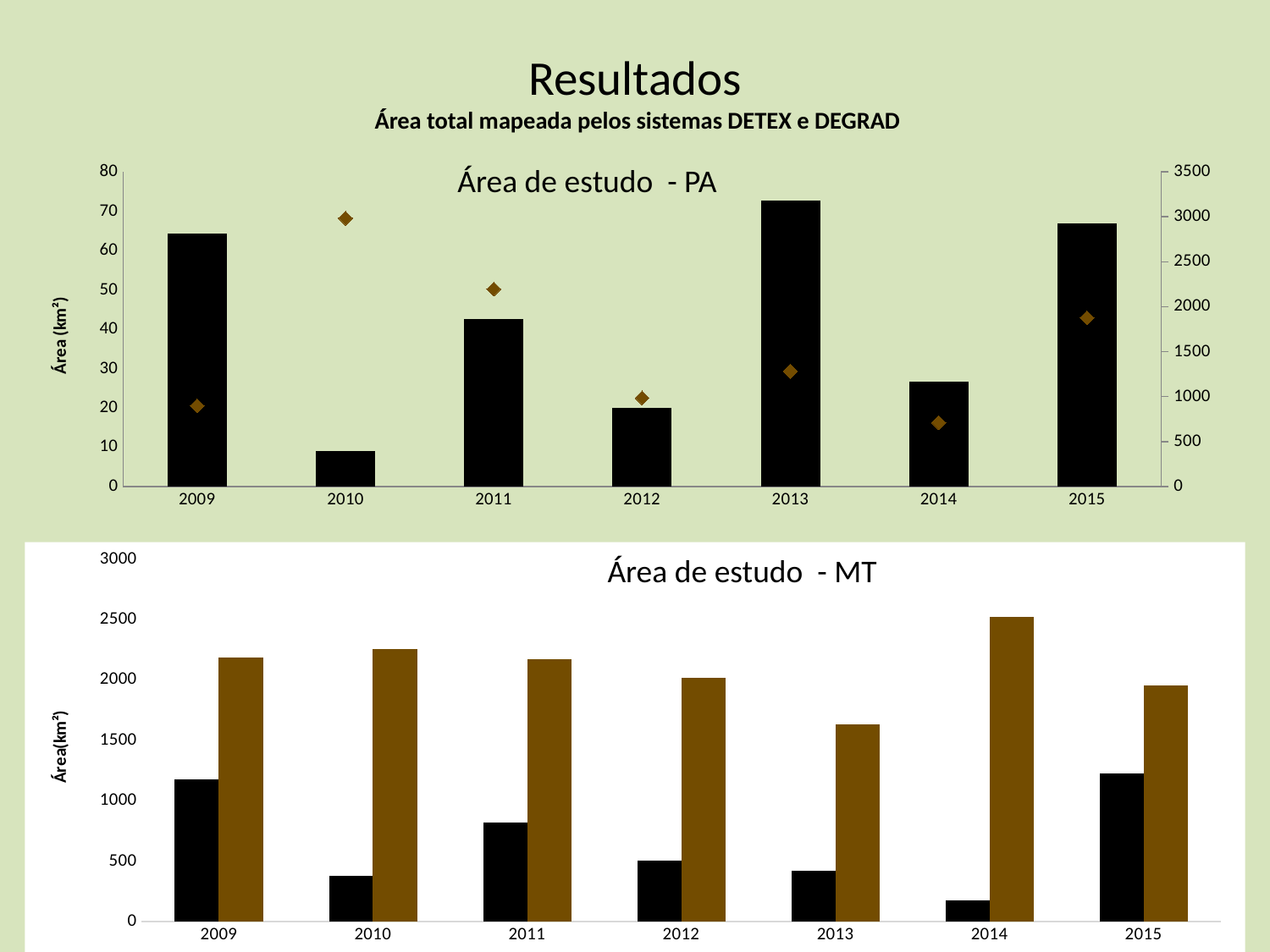
What kind of chart is the 'Área de estudo - MT' chart? bar chart In the 'Área de estudo - MT' chart, which year has the shortest black bar? 2014 In the 'Área de estudo - PA' chart, which year has the tallest bar? 2013 In the 'Área de estudo - MT' chart, is the black bar for 2009 greater or less than 1000? greater In the 'Área de estudo - PA' chart, which year has the shortest bar? 2010 In the 'Área de estudo - PA' chart, is the bar for 2009 greater or less than 60 on the left axis? greater In the 'Área de estudo - MT' chart, which year has the tallest brown bar? 2014 In the 'Área de estudo - PA' chart, is the diamond marker for 2014 greater or less than 1000 on the right axis? less In the 'Área de estudo - PA' chart, which year has the highest diamond marker? 2010 In the 'Área de estudo - MT' chart, which year has the shortest brown bar? 2013 How many years are shown on the x axis of the 'Área de estudo - MT' chart? 7 In the 'Área de estudo - MT' chart, which is larger for 2011, the black bar or the brown bar? the brown bar